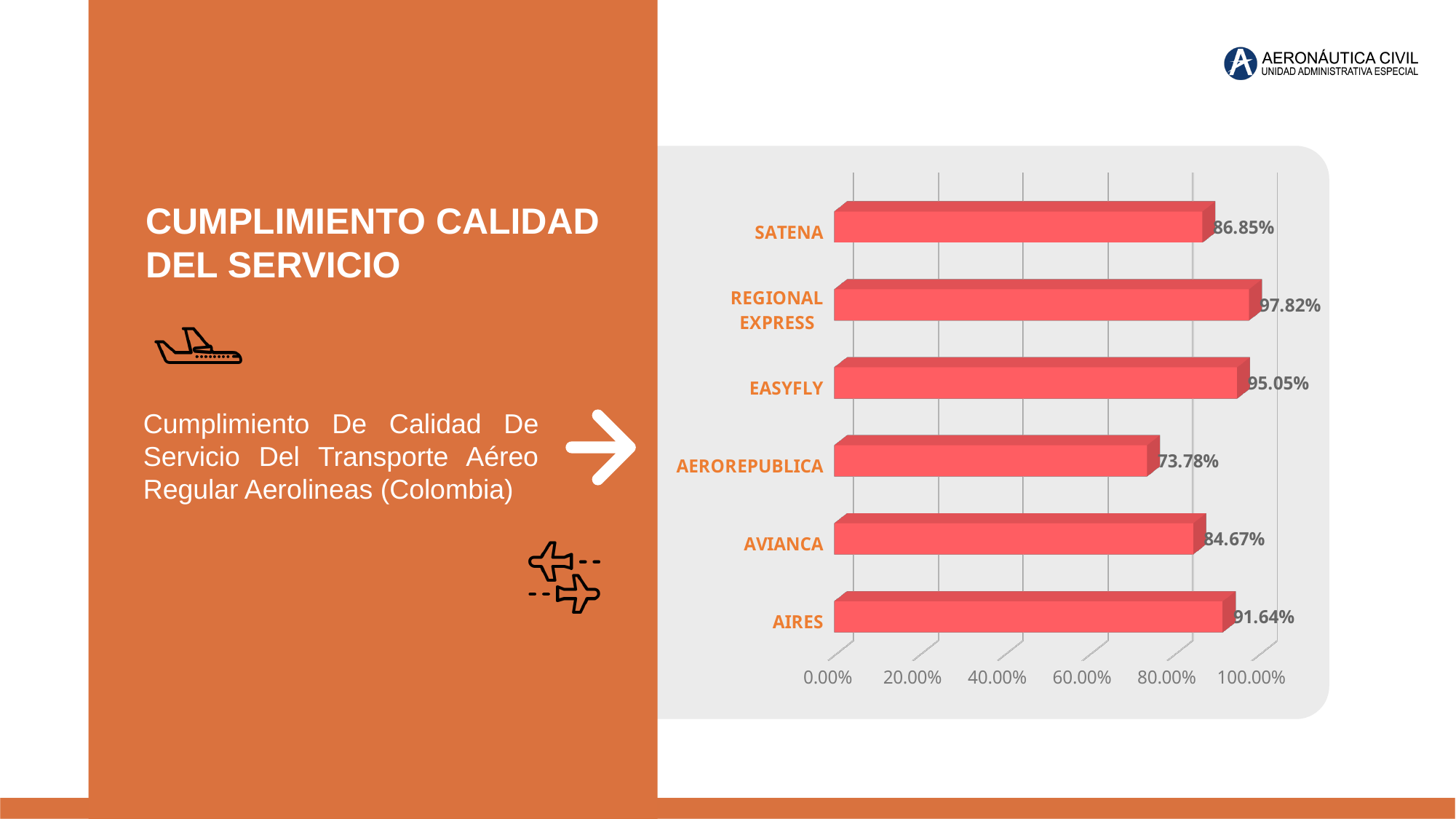
What kind of chart is shown on the slide? bar chart What is the value for SATENA? 86.85% Which is larger, the value for SATENA or the value for AVIANCA? SATENA What is the value for AEROREPUBLICA? 73.78% What is the difference between the values for EASYFLY and AVIANCA? 10.38% Which airline has the highest value? REGIONAL EXPRESS What is the highest tick label shown on the horizontal axis? 100.00% What is the value for REGIONAL EXPRESS? 97.82% Which airline has the lowest value? AEROREPUBLICA What is the value for AIRES? 91.64% Is the value for AEROREPUBLICA greater or less than 80.00%? less How many airlines are shown in the chart? 6